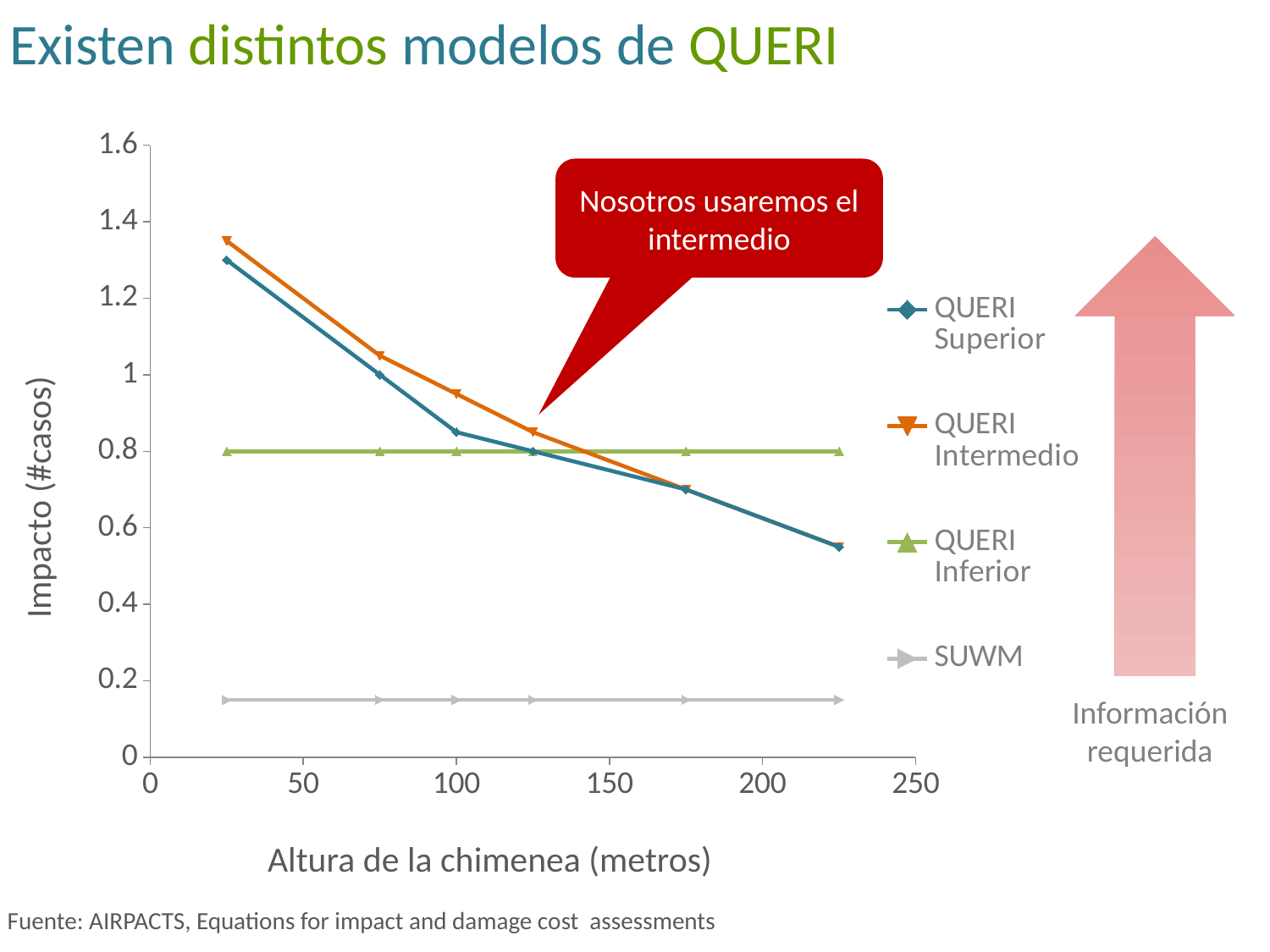
Does the QUERI Inferior series rise, fall or stay flat as chimney height increases? stay flat How many series does the legend list? 4 Which series has the lowest values across all chimney heights? SUWM How many data points does the QUERI Intermedio series have? 6 At 100 metros, which is larger: QUERI Intermedio or QUERI Superior? QUERI Intermedio Does the QUERI Intermedio series rise or fall as chimney height increases? fall Is the value of QUERI Superior at 25 metros greater or less than 1.2? greater Is the value of QUERI Intermedio at 225 metros greater or less than 0.6? less What is the value of QUERI Inferior at a chimney height of 100 metros? 0.8 What kind of chart is shown on the slide? line chart What is the title of the x axis? Altura de la chimenea (metros) Is the value of SUWM at 225 metros greater or less than 0.2? less